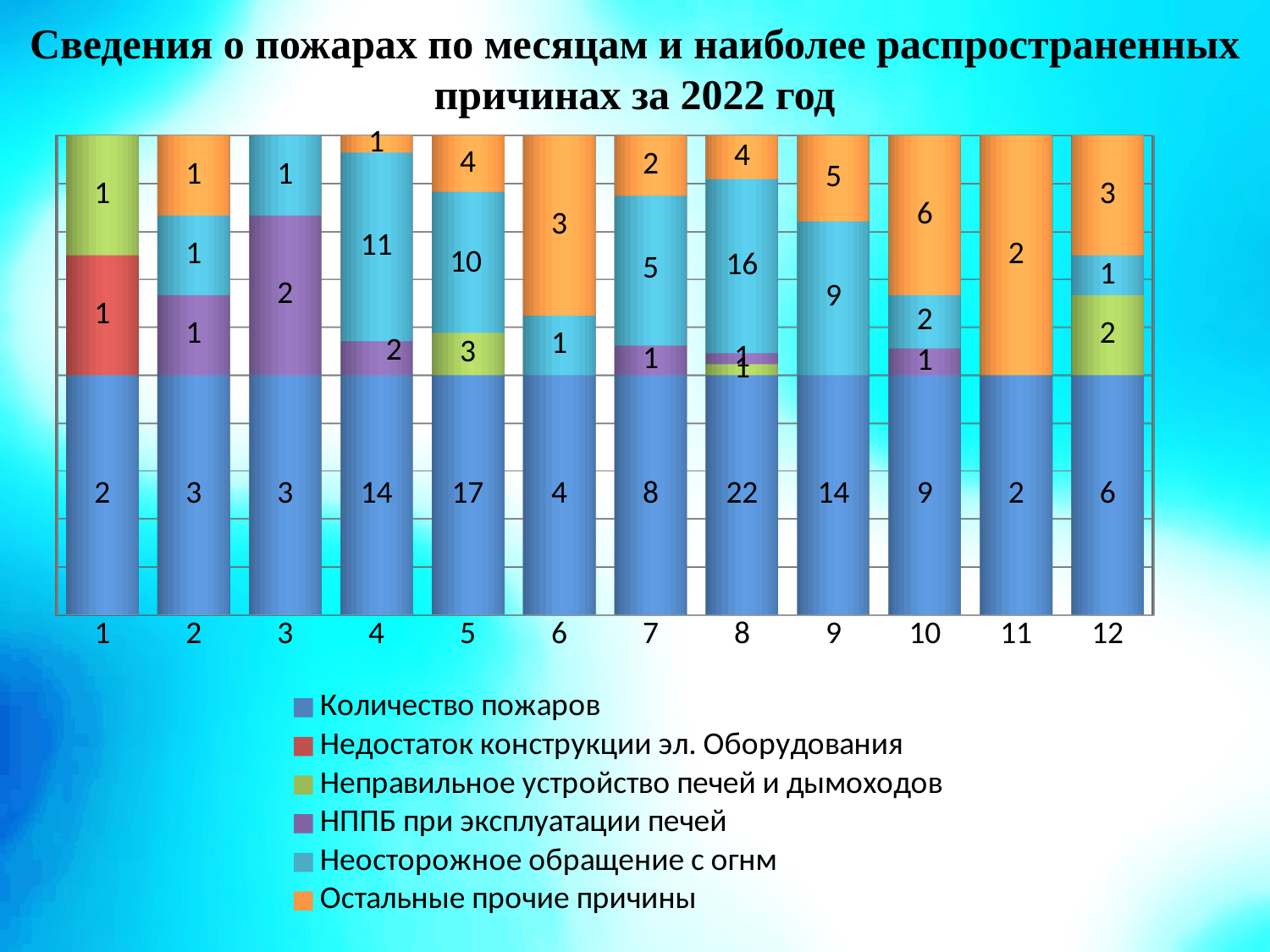
Which is larger: Неосторожное обращение с огнм for month 9 or for month 7? month 9 How many months are shown on the x axis? 12 How many series does the legend list? 6 Which month has the highest value of Количество пожаров? 8 Which series is shown in red in the legend? Недостаток конструкции эл. Оборудования What is the value of Неправильное устройство печей и дымоходов for month 12? 2 What kind of chart is shown on the slide? stacked bar chart What is the difference between Количество пожаров for month 5 and month 4? 3 What is the value of Остальные прочие причины for month 10? 6 Which month has the highest value of Остальные прочие причины? 10 What is the value of Неосторожное обращение с огнм for month 4? 11 What is the value of Количество пожаров for month 8? 22